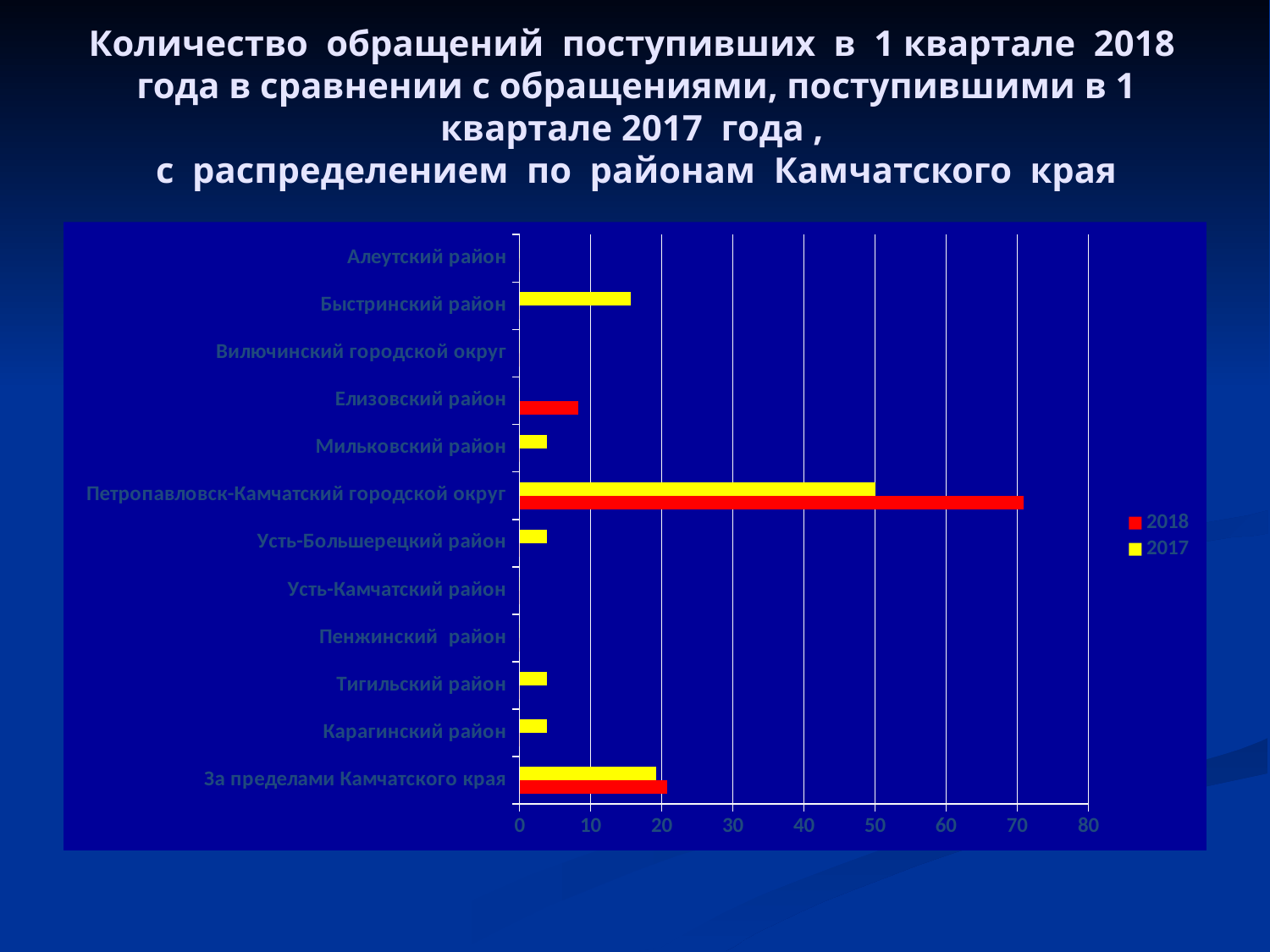
For Петропавловск-Камчатский городской округ, which year has the larger value, 2018 or 2017? 2018 Which is larger: the 2017 value for Быстринский район or the 2017 value for Мильковский район? Быстринский район Which category has the highest value for 2017? Петропавловск-Камчатский городской округ Is the 2018 value for Петропавловск-Камчатский городской округ greater or less than 60? greater How many categories (districts) are listed on the vertical axis? 12 Is the 2017 value for Быстринский район greater or less than 10? greater What kind of chart is shown on the slide? bar chart Which category has the highest value for 2018? Петропавловск-Камчатский городской округ Which colour represents the 2017 series in the legend? yellow Is the 2018 value for Елизовский район greater or less than 10? less Which colour represents the 2018 series in the legend? red How many series does the legend list? 2